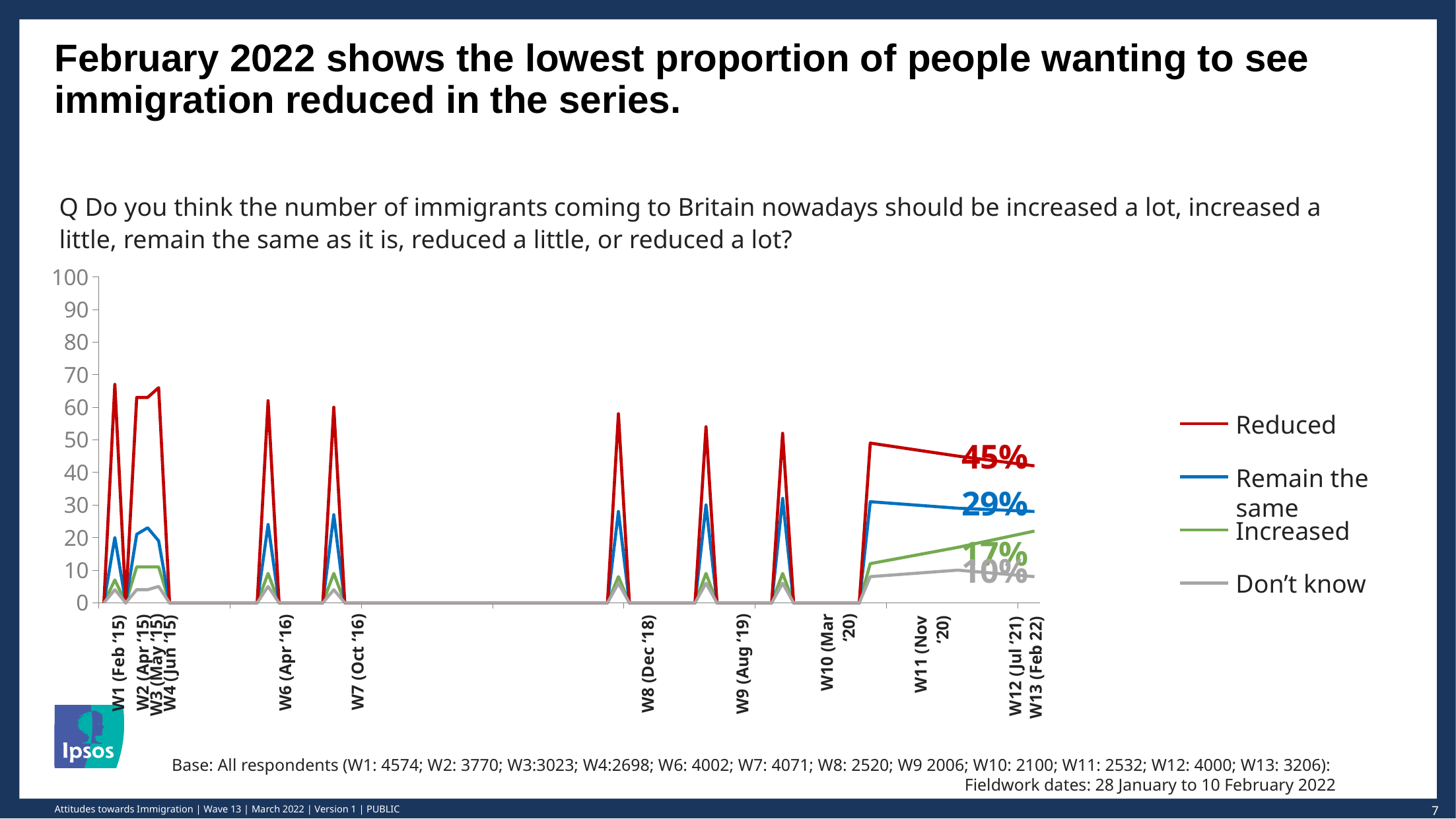
Is the value for Don't know at W13 (Feb 22) greater or less than 10? less What value is printed as the data label on the Increased line? 17% Does the Reduced line rise or fall from W11 (Nov '20) to W13 (Feb 22)? fall At W13 (Feb 22), which is larger: Reduced or Remain the same? Reduced Which series has the highest value at W1 (Feb '15)? Reduced Is the value for Reduced at W1 (Feb '15) greater or less than 60? greater What value is printed as the data label on the Reduced line? 45% How many series does the legend list? 4 What kind of chart is shown on the slide? line chart What value is printed as the data label on the Remain the same line? 29% What value is printed as the data label on the Don't know line? 10% Is the value for Reduced at W13 (Feb 22) greater or less than 50? less